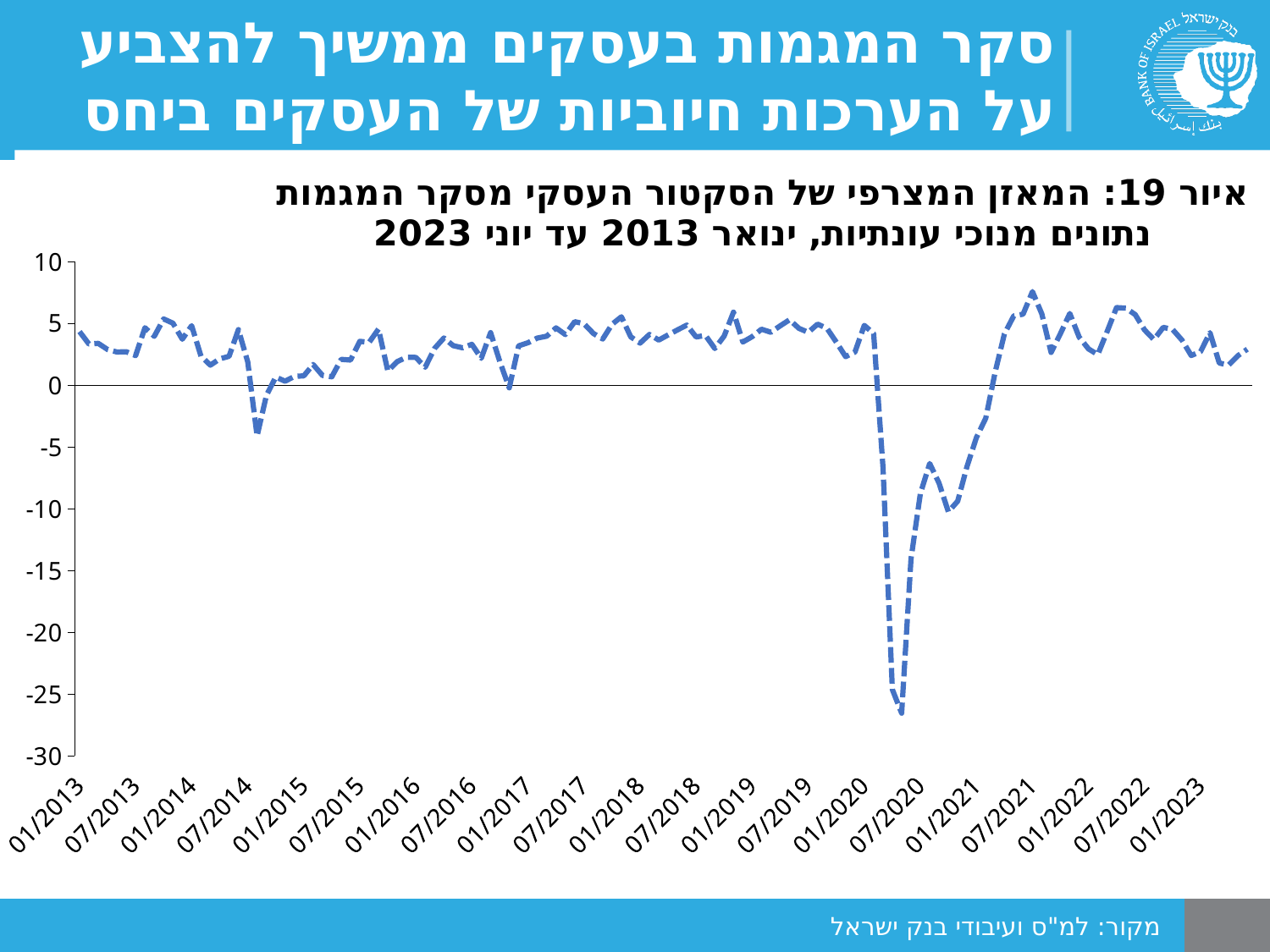
What is the lowest value shown on the y axis of the chart? -30 How many lines (series) are plotted on the chart? 1 Is the lowest point of the line in 2014 greater or less than 0? less What is the source stated at the bottom of the slide? למ"ס ועיבודי בנק ישראל Between 01/2020 and the trough in mid-2020, does the line rise or fall? fall Is the value of the line at 01/2013 greater or less than 0? greater How many date labels are shown along the x axis of the chart? 21 Between the 2020 trough and 07/2021, does the line rise or fall? rise Is the value of the line at 01/2023 greater or less than 0? greater What kind of chart is shown on the slide? line chart